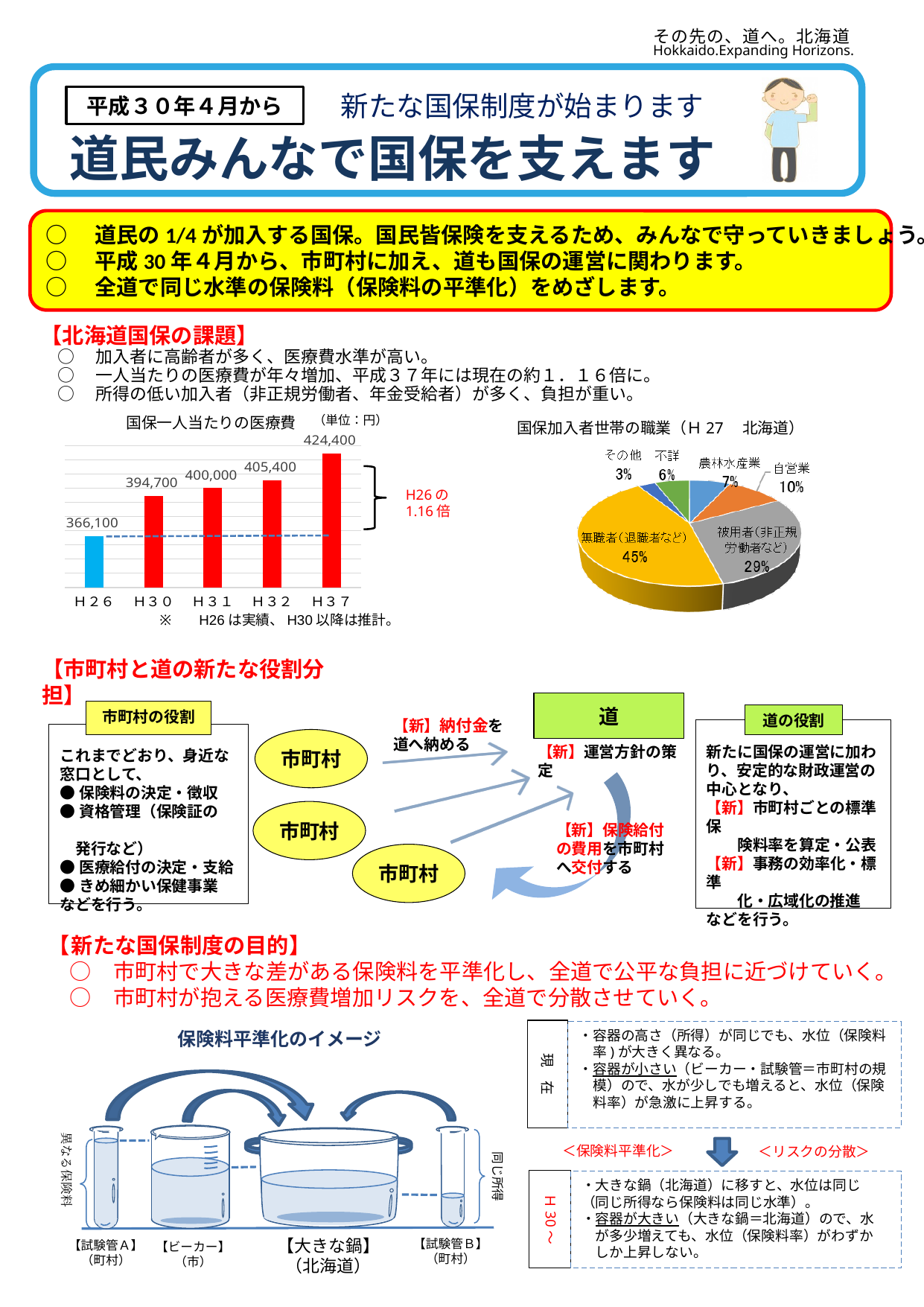
In the pie chart 国保加入者世帯の職業, which category has the smallest share? その他 In the bar chart 国保一人当たりの医療費, which year has the highest value? H37 In the bar chart 国保一人当たりの医療費, what is the value for H31? 400,000 In the bar chart 国保一人当たりの医療費, which year has the lowest value? H26 In the bar chart 国保一人当たりの医療費, what is the value for H37? 424,400 In the pie chart 国保加入者世帯の職業, which is larger, 自営業 or 農林水産業? 自営業 In the bar chart 国保一人当たりの医療費, what is the difference between the H37 value and the H26 value? 58,300 In the bar chart 国保一人当たりの医療費, what is the value for H26? 366,100 What kind of chart is 国保加入者世帯の職業（H27 北海道）? pie chart In the bar chart 国保一人当たりの医療費, do the values rise or fall from H26 to H37? rise How many bars are shown in the bar chart 国保一人当たりの医療費? 5 In the pie chart 国保加入者世帯の職業, what share is 無職者(退職者など)? 45%